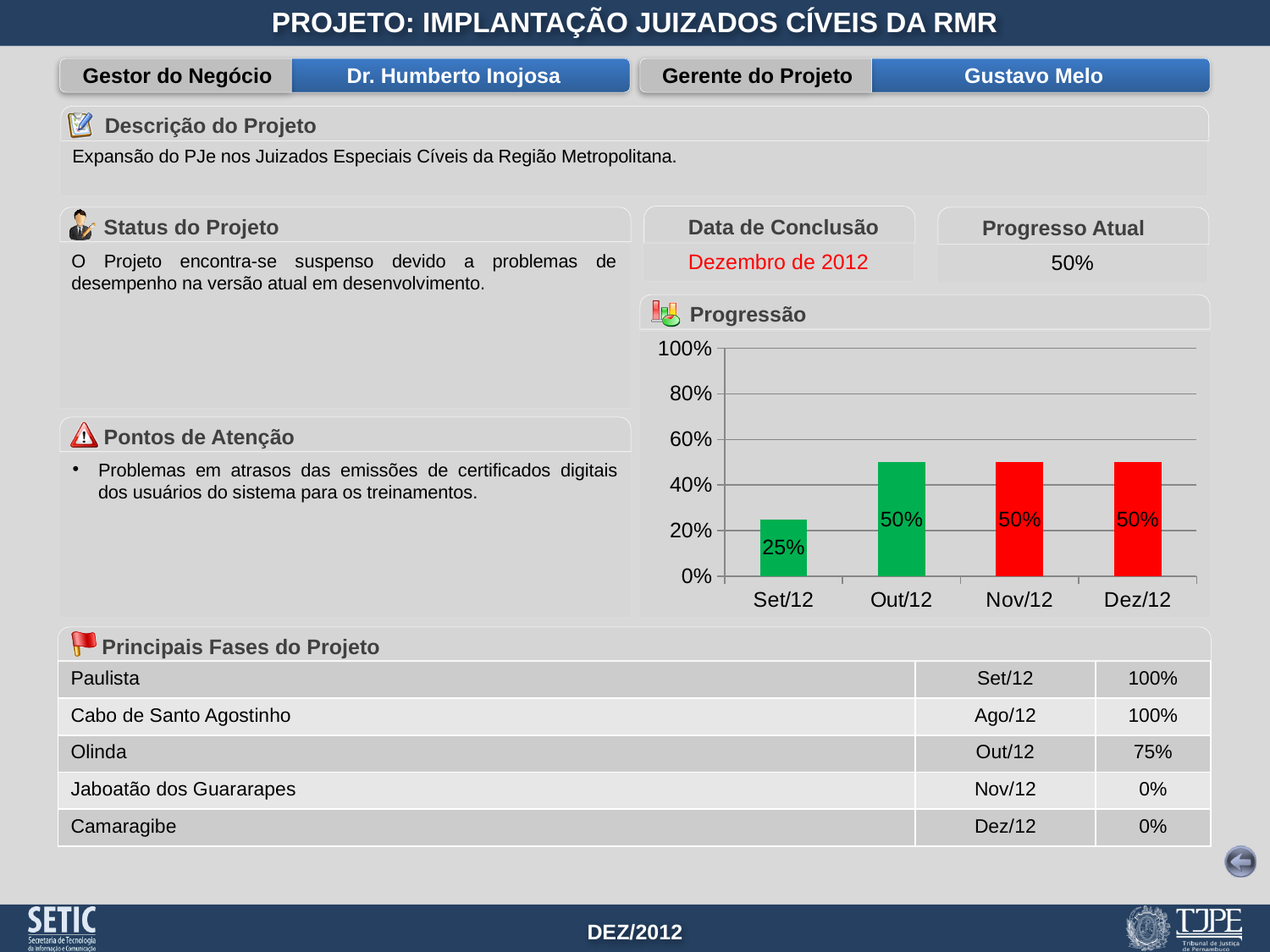
What is the value for Out/12 in the Progressão chart? 50% What is the difference between the values for Out/12 and Set/12 in the Progressão chart? 25% Which month has the lowest value in the Progressão chart? Set/12 What is the value for Dez/12 in the Progressão chart? 50% Which is larger in the Progressão chart, the value for Set/12 or the value for Nov/12? Nov/12 Does the value in the Progressão chart rise or fall from Set/12 to Out/12? rise What kind of chart is the Progressão chart? bar chart Is the value for Set/12 in the Progressão chart greater or less than 40%? less What is the title of the chart on the slide? Progressão What colour are the bars for Nov/12 and Dez/12 in the Progressão chart? red What is the value for Set/12 in the Progressão chart? 25% How many months are shown on the x axis of the Progressão chart? 4